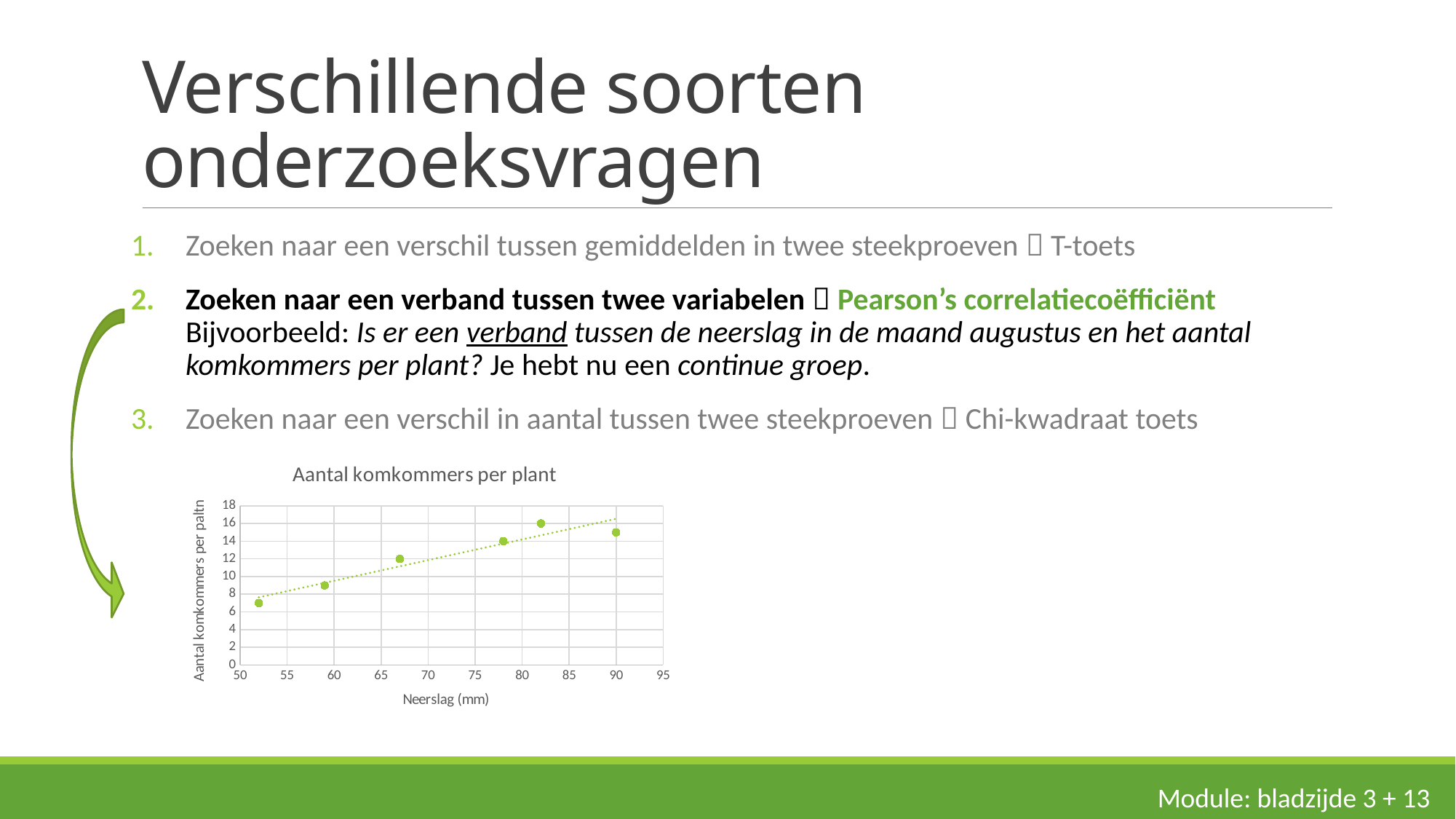
Which point has the highest number of komkommers per plant: the one at about 82 mm or the one at 90 mm Neerslag? the one at about 82 mm Do the values generally rise or fall as Neerslag (mm) increases along the x axis? rise Which point has the lowest number of komkommers per plant? the leftmost point, at about 52 mm Neerslag How many data points are plotted in the chart? 6 Is the value for the point at about 59 mm Neerslag greater or less than 10? less Is the value for the point at 90 mm Neerslag greater or less than 14? greater What kind of chart is shown on the slide? scatter chart Is the value for the point at about 82 mm Neerslag greater or less than 14? greater What is the maximum value shown on the y axis of the chart? 18 What is the label of the x axis of the chart? Neerslag (mm) What is the title of the chart? Aantal komkommers per plant